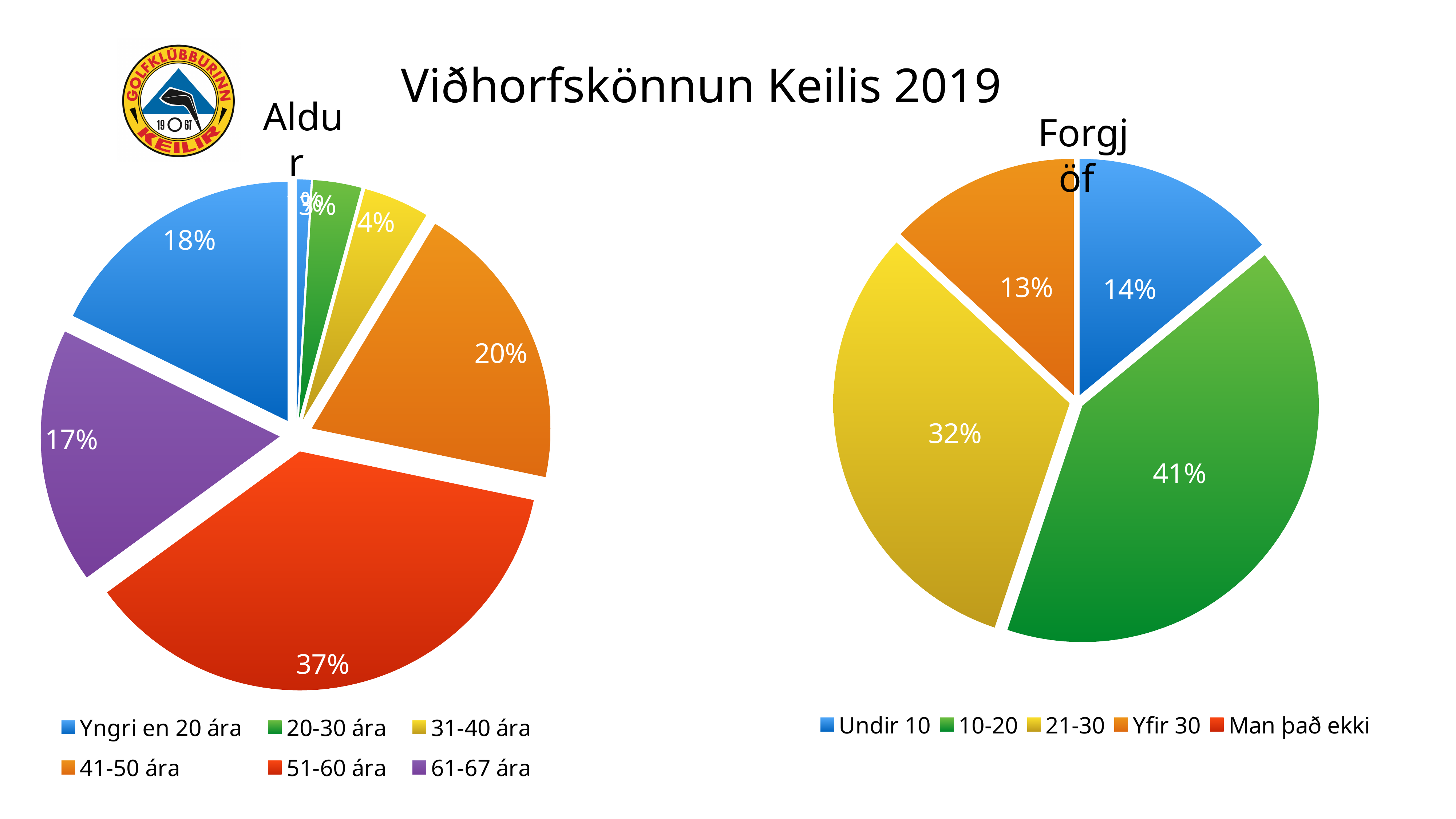
In the Forgjöf pie chart, which is larger, Undir 10 or Yfir 30? Undir 10 In the Aldur pie chart, what share is shown for 61-67 ára? 17% In the Aldur pie chart, what share is shown for 41-50 ára? 20% In the Aldur pie chart, which age group has the largest slice? 51-60 ára What kind of chart is the Aldur chart? Pie chart In the Forgjöf pie chart, which category has the largest slice? 10-20 In the Forgjöf pie chart, what share is shown for 10-20? 41% In the Aldur pie chart, how many percentage points larger is the 51-60 ára slice than the 41-50 ára slice? 17 percentage points How many entries does the legend of the Forgjöf chart list? 5